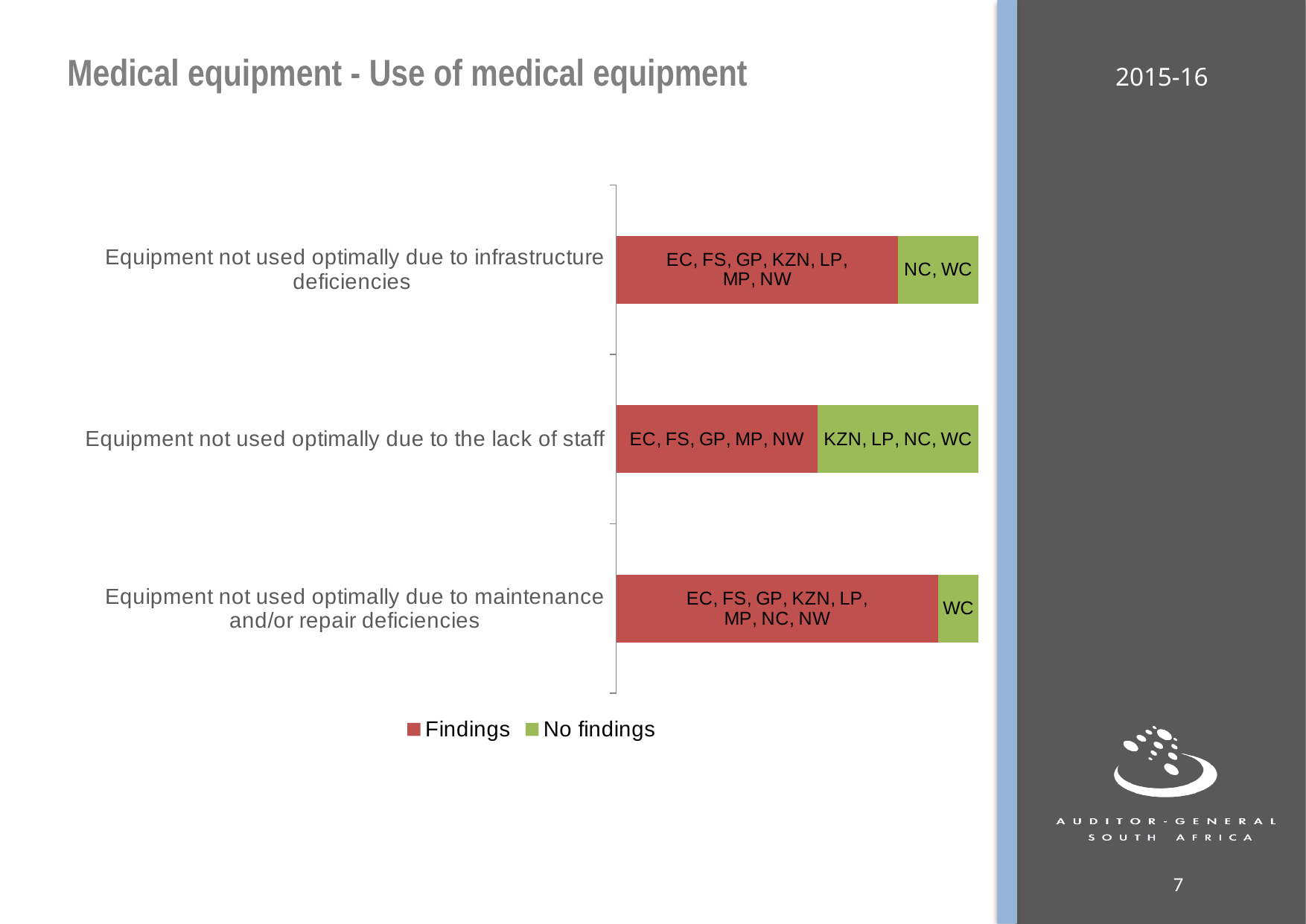
Which category has the largest Findings segment? Equipment not used optimally due to maintenance and/or repair deficiencies What kind of chart is shown on the slide? Stacked bar chart Which provinces are listed in the Findings segment for 'Equipment not used optimally due to maintenance and/or repair deficiencies'? EC, FS, GP, KZN, LP, MP, NC, NW Which province is listed in the No findings segment for 'Equipment not used optimally due to maintenance and/or repair deficiencies'? WC How many categories are plotted on the chart? 3 Which category has the smallest Findings segment? Equipment not used optimally due to the lack of staff How many series does the legend list? 2 What are the two series named in the legend? Findings and No findings Which provinces are listed in the No findings segment for 'Equipment not used optimally due to infrastructure deficiencies'? NC, WC Which provinces are listed in the Findings segment for 'Equipment not used optimally due to the lack of staff'? EC, FS, GP, MP, NW For 'Equipment not used optimally due to infrastructure deficiencies', which segment is larger, Findings or No findings? Findings Which provinces are listed in the No findings segment for 'Equipment not used optimally due to the lack of staff'? KZN, LP, NC, WC